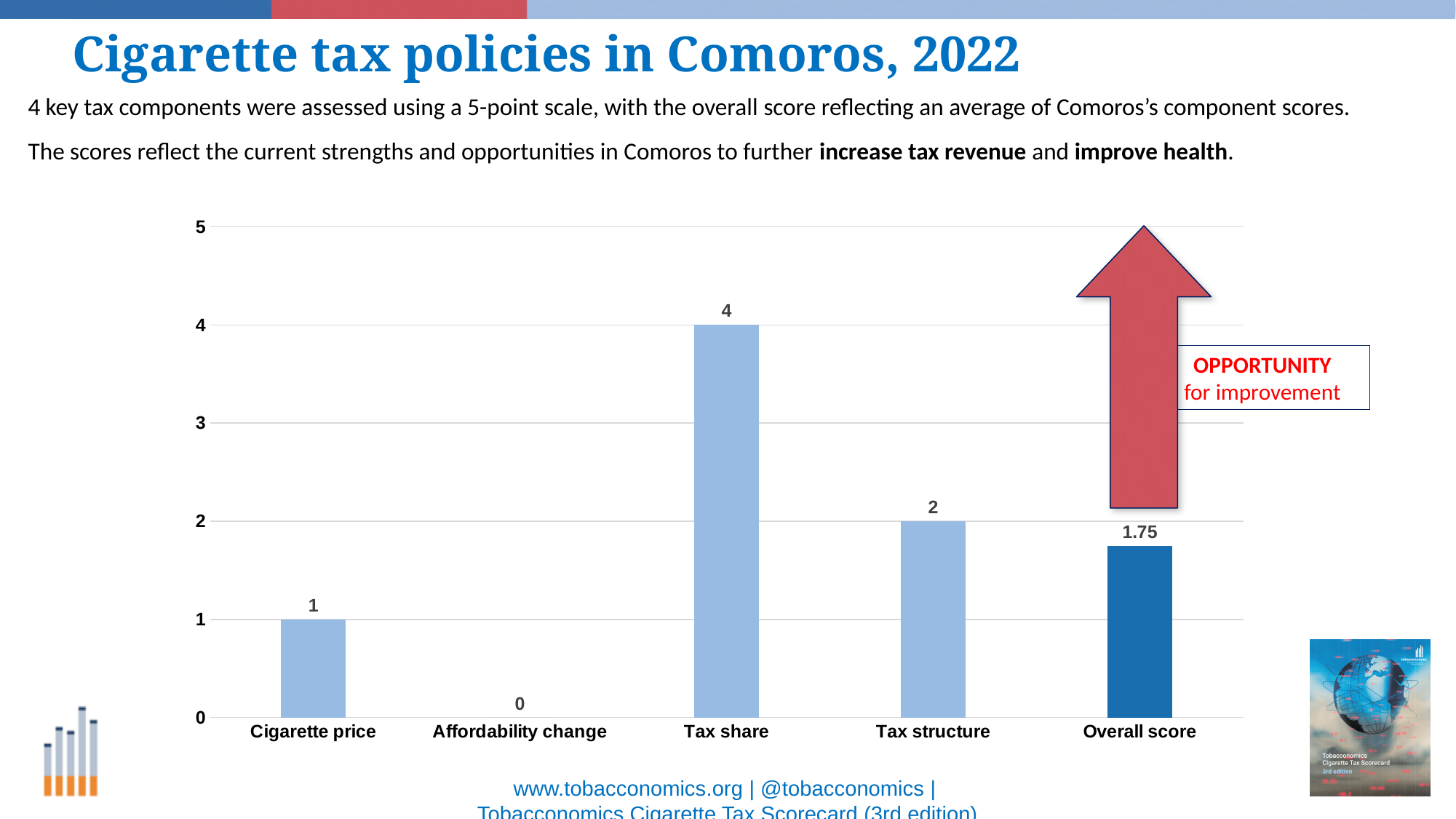
What is the value for Tax share? 4 What is the value for Overall score? 1.75 What is the value for Affordability change? 0 Which is larger, the value for Tax structure or the value for Overall score? Tax structure How many categories are shown on the x axis? 5 What kind of chart is shown on the slide? bar chart Which category has the lowest value? Affordability change What is the value for Cigarette price? 1 What is the difference between the values for Tax share and Tax structure? 2 Which category has the highest value? Tax share Is the value for Tax share greater or less than 3? greater What is the maximum value shown on the y axis? 5